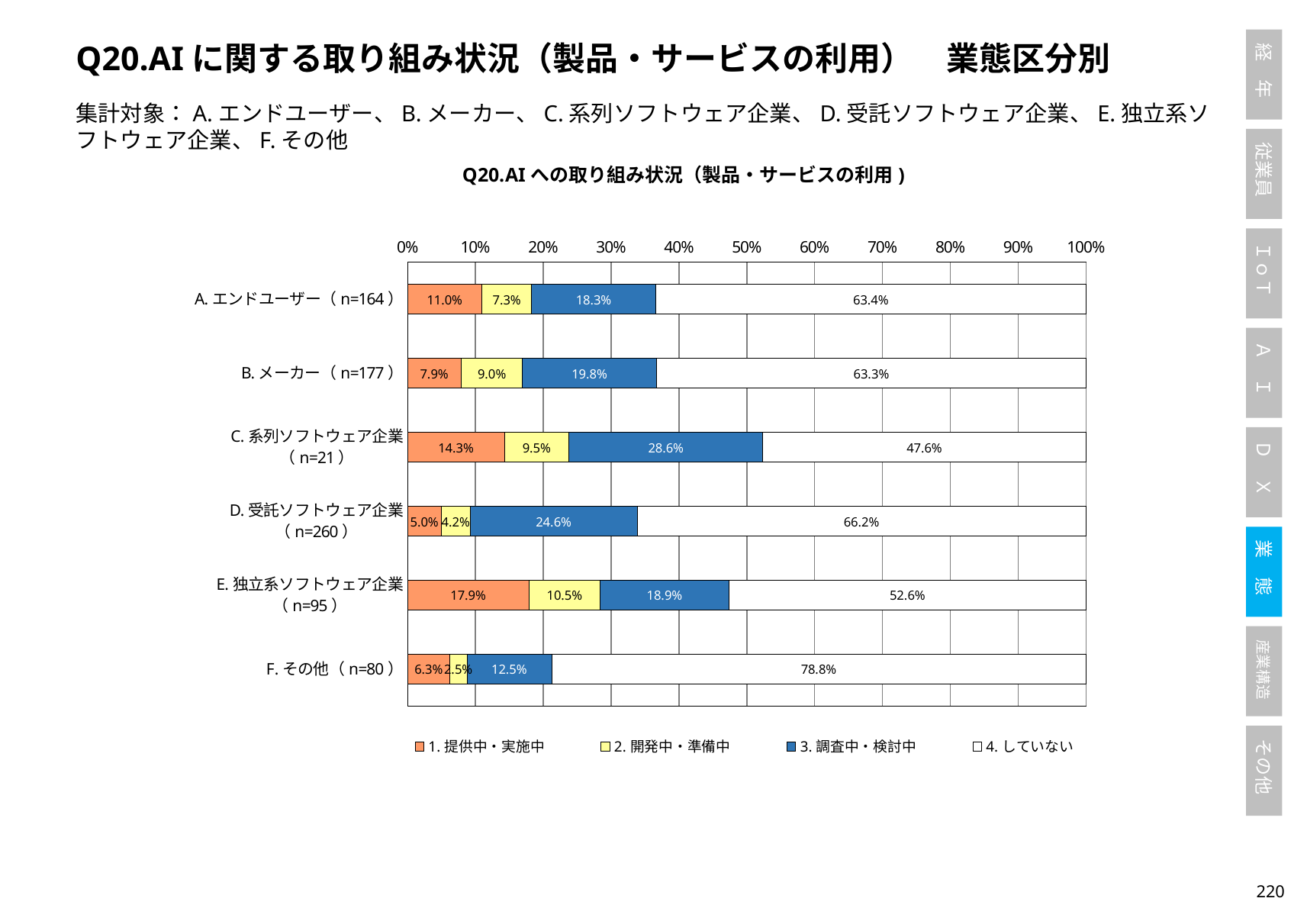
What is the value of "2. 開発中・準備中" for "D. 受託ソフトウェア企業"? 4.2% How many categories (business types) are plotted on the chart? 6 Which category has the lowest value for "1. 提供中・実施中"? D. 受託ソフトウェア企業 What is the value of "1. 提供中・実施中" for "E. 独立系ソフトウェア企業"? 17.9% Which category has the highest value for "4. していない"? F. その他 What is the value of "3. 調査中・検討中" for "C. 系列ソフトウェア企業"? 28.6% Which is larger: the "1. 提供中・実施中" value for "A. エンドユーザー" or for "B. メーカー"? A. エンドユーザー What type of chart is shown on the slide? Stacked bar chart How many series does the legend list? 4 What is the value of "4. していない" for "F. その他"? 78.8% What is the difference between the "3. 調査中・検討中" values for "D. 受託ソフトウェア企業" and "F. その他"? 12.1% What is the sample size (n) shown for "B. メーカー"? 177